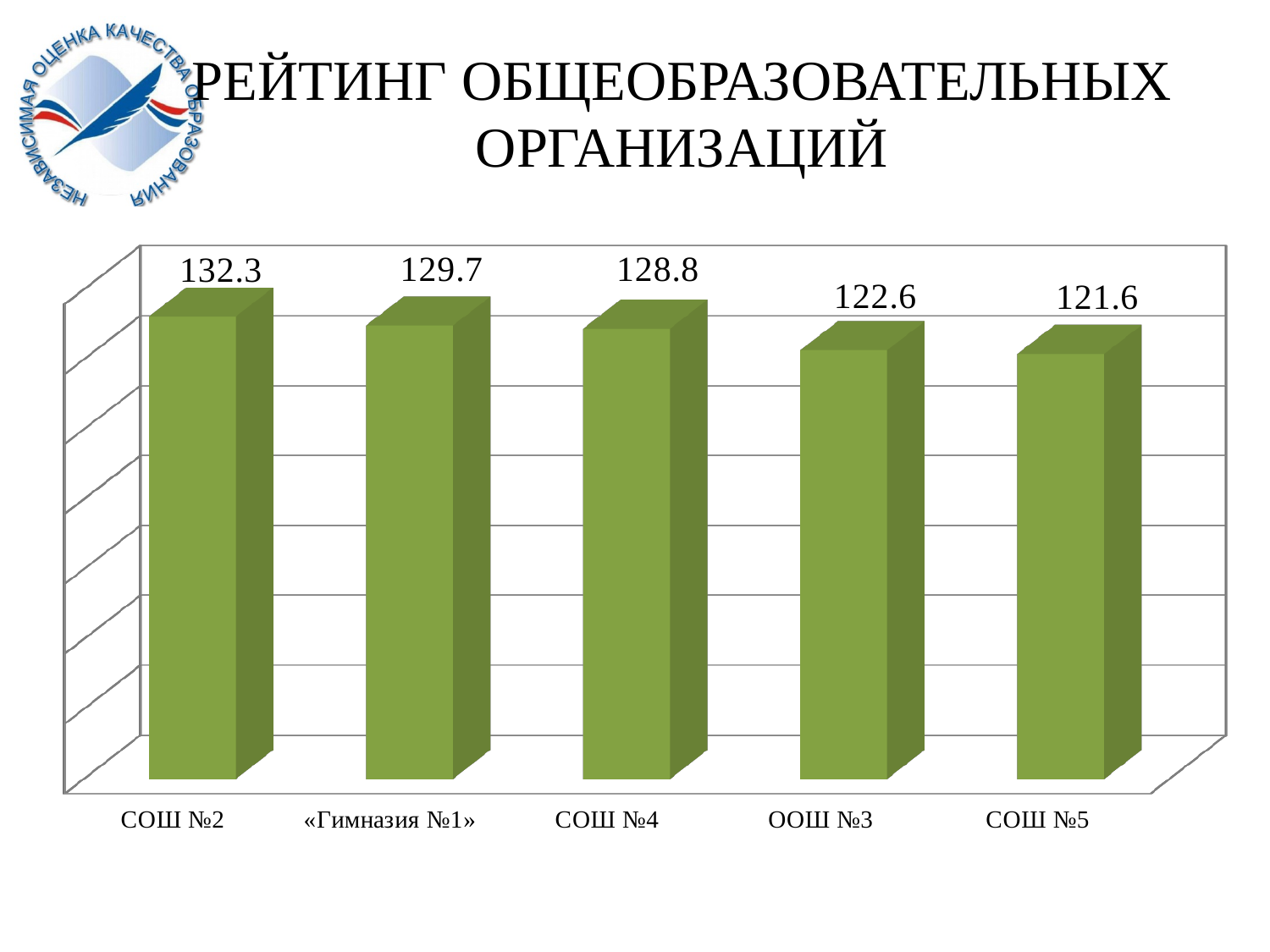
What is the value for СОШ №5? 121.6 What is the value for СОШ №2? 132.3 Do the values rise or fall from left to right across the chart? Fall What is the difference between the values for «Гимназия №1» and СОШ №4? 0.9 Which organisation has the lowest value? СОШ №5 How many organisations are shown in the chart? 5 What is the value for «Гимназия №1»? 129.7 Which has a larger value, СОШ №4 or ООШ №3? СОШ №4 Which organisation has the highest value? СОШ №2 What is the value for ООШ №3? 122.6 What is the difference between the values for СОШ №2 and СОШ №5? 10.7 What kind of chart is shown on the slide? Bar chart